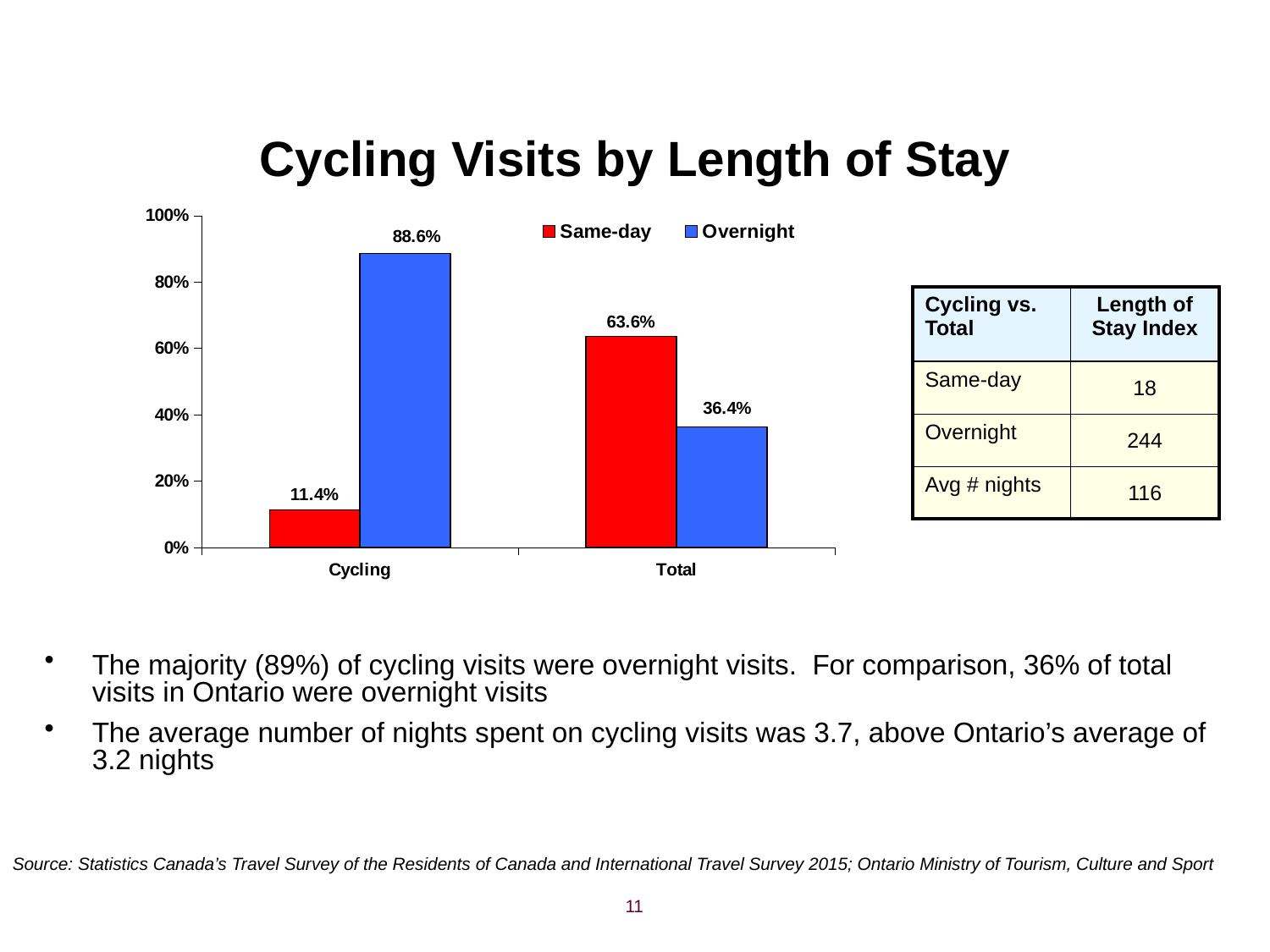
Which is larger for Total: Same-day or Overnight? Same-day Is the Overnight value for Cycling greater or less than 80%? greater What is the Overnight value for Total? 36.4% How many categories are shown on the x axis? 2 Which category has the lowest Same-day value? Cycling Which category has the highest Overnight value? Cycling What is the Overnight value for Cycling? 88.6% What kind of chart is shown? bar chart What is the Same-day value for Cycling? 11.4% What is the difference between the Overnight values for Cycling and Total? 52.2% How many series does the legend list? 2 What is the Same-day value for Total? 63.6%